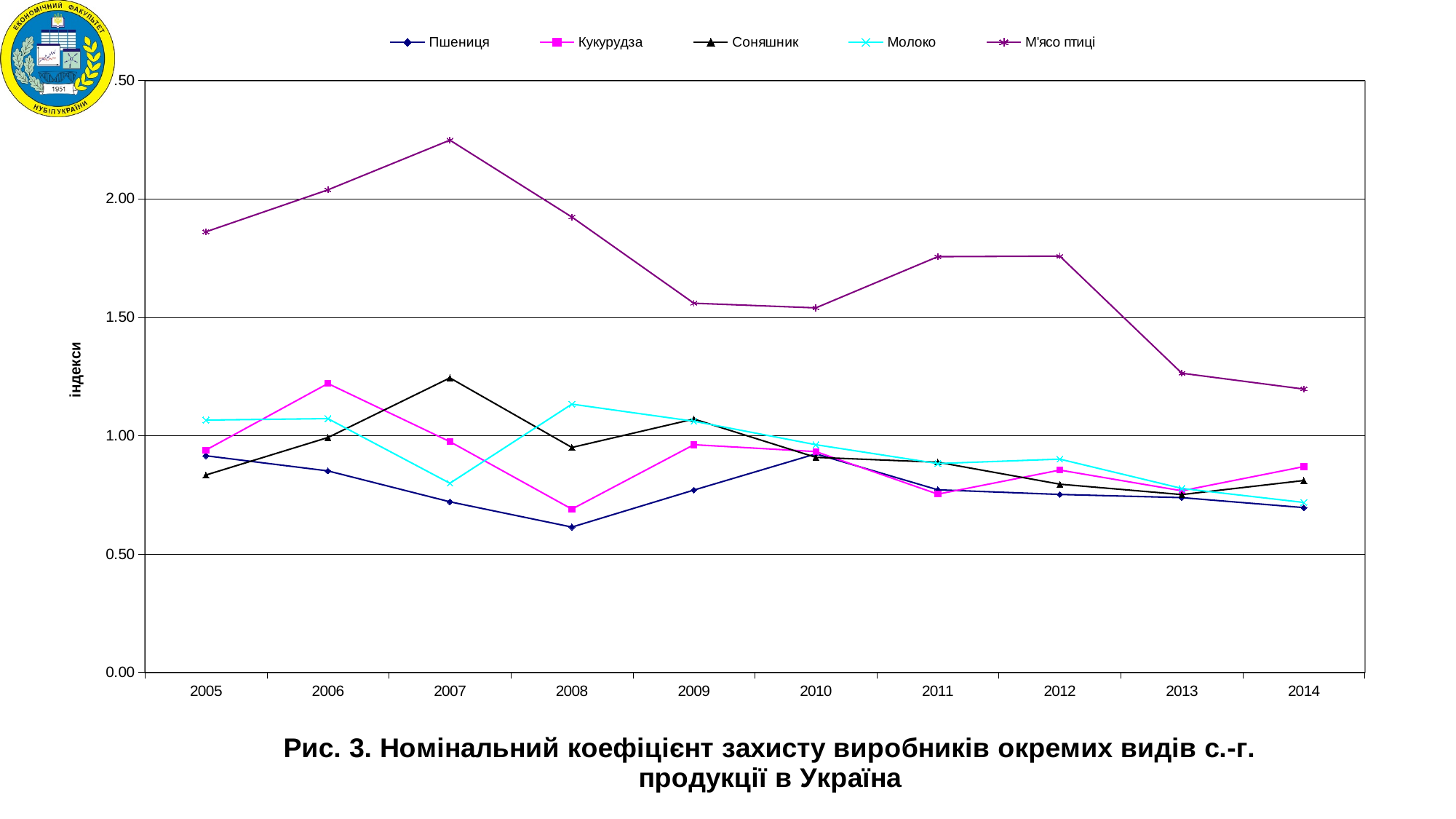
What is the label on the vertical axis? індекси In which year does the Пшениця series reach its lowest value? 2008 What kind of chart is shown on the slide? line chart Is the value for М'ясо птиці in 2007 greater or less than 2.00? greater Is the value for Кукурудза in 2006 greater or less than 1.00? greater How many series does the legend list? 5 Does the М'ясо птиці series rise or fall from 2012 to 2014? fall Is the value for М'ясо птиці in 2013 greater or less than 1.50? less Which series has the highest value in 2007? М'ясо птиці In which year does the М'ясо птиці series reach its highest value? 2007 How many years are shown on the x axis? 10 Which is larger in 2006, the value for Кукурудза or the value for Пшениця? Кукурудза